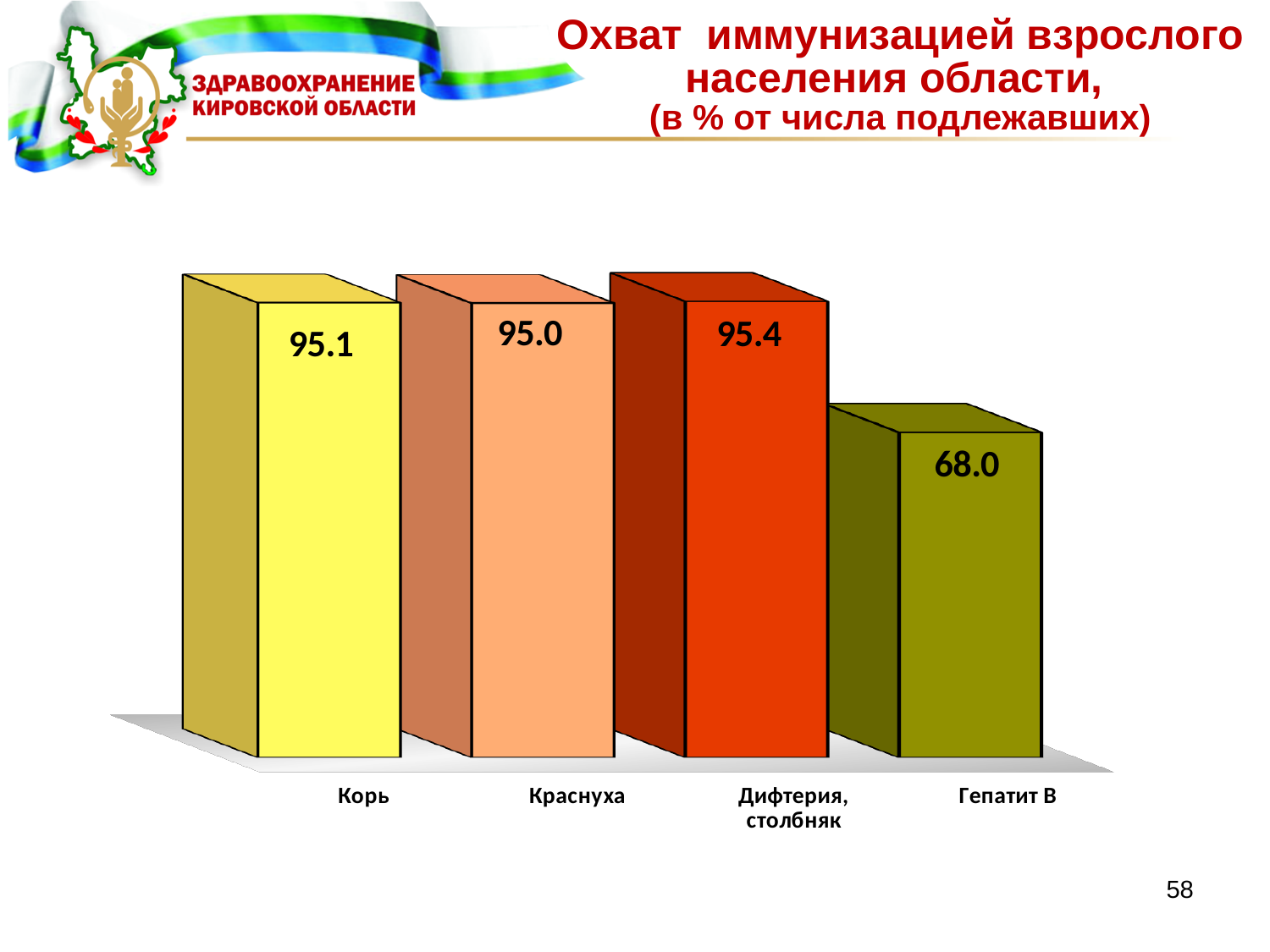
Which category has the highest value? Дифтерия, столбняк What colour is the bar for Дифтерия, столбняк? Red What value is shown for Гепатит В? 68.0 What is the difference between the values for Корь and Гепатит В? 27.1 What value is shown for Краснуха? 95.0 How many categories are shown in the chart? 4 Which is larger, the value for Корь or the value for Краснуха? Корь What kind of chart is shown on the slide? Bar chart Which category has the lowest value? Гепатит В What is the difference between the values for Дифтерия, столбняк and Гепатит В? 27.4 What is the immunization coverage value shown for Корь? 95.1 What value is shown for Дифтерия, столбняк? 95.4